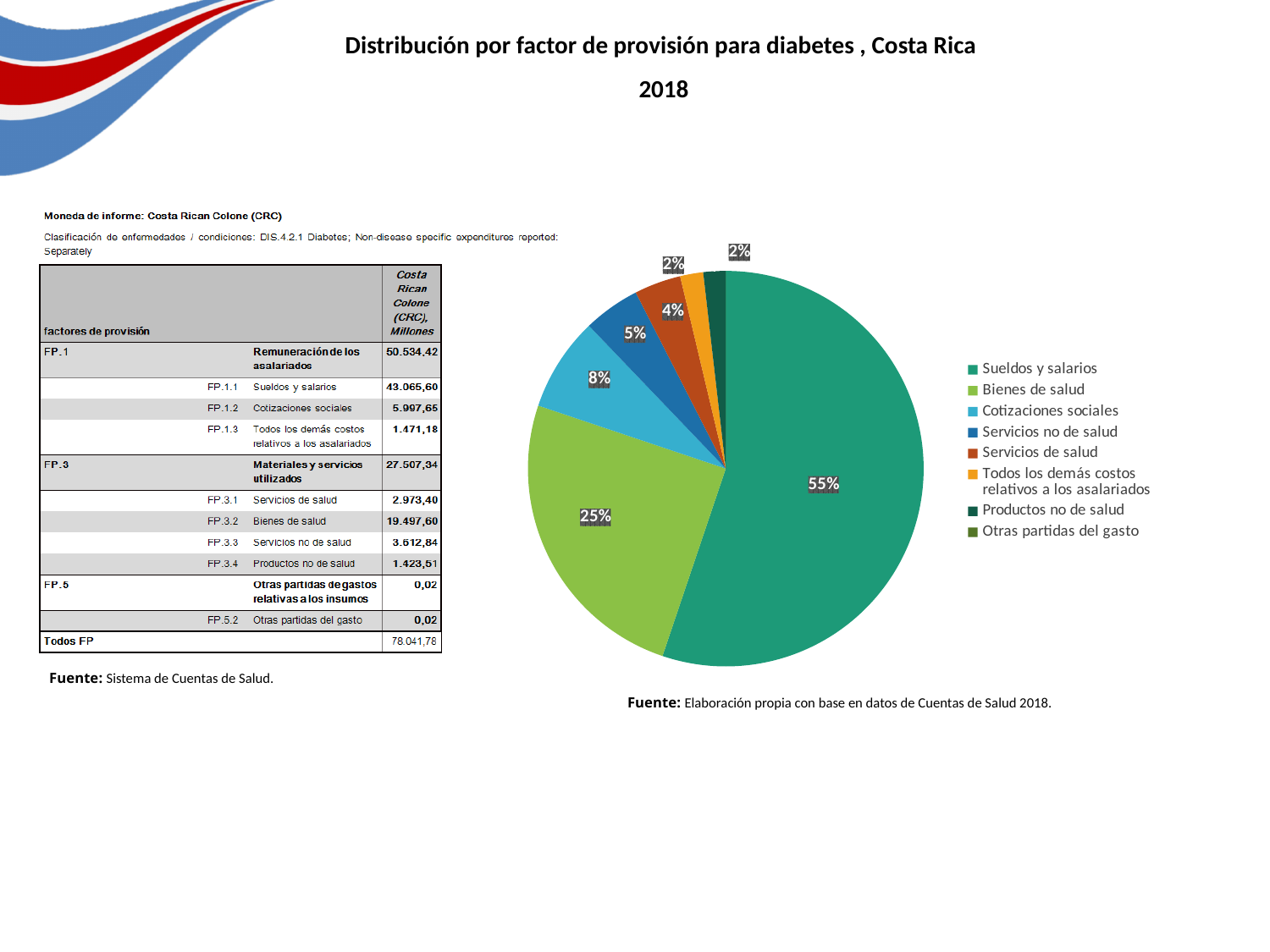
What share of the pie does Bienes de salud represent? 25% What share of the pie does Servicios no de salud represent? 5% Which category has the largest slice of the pie? Sueldos y salarios What is the difference in percentage points between Sueldos y salarios and Bienes de salud? 30 Which slice is larger, Cotizaciones sociales or Servicios no de salud? Cotizaciones sociales What kind of chart is shown on the slide? pie chart What share of the pie does Sueldos y salarios represent? 55% What share of the pie does Cotizaciones sociales represent? 8% How many entries does the legend of the pie chart list? 8 What colour is the slice for Sueldos y salarios in the pie chart? teal green What share of the pie does Servicios de salud represent? 4% What is the title of the slide containing the pie chart? Distribución por factor de provisión para diabetes , Costa Rica 2018